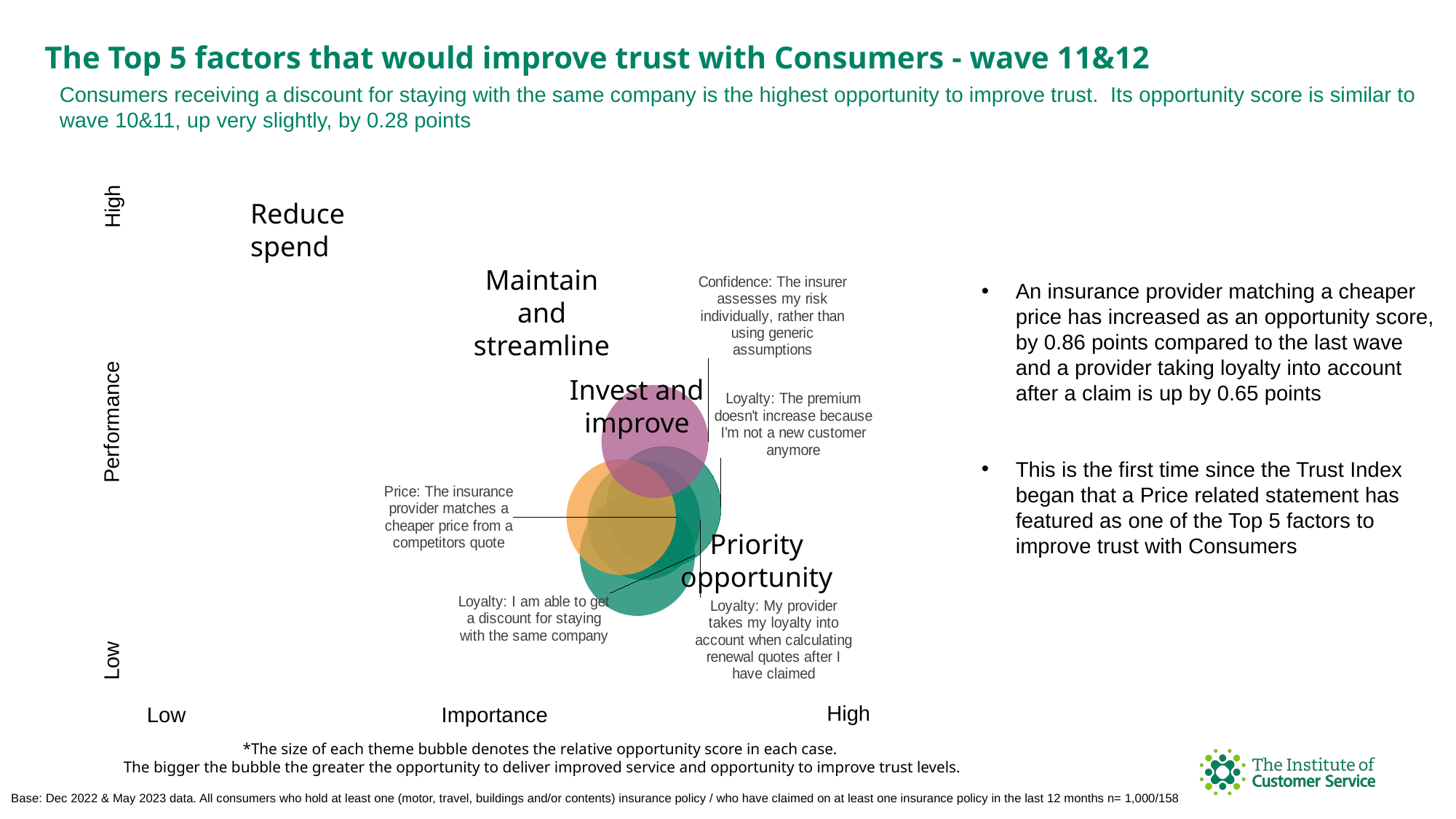
What is the name of the quadrant in the bottom-right of the chart? Priority opportunity How many factor bubbles are plotted on the chart? 5 Which factor has the largest bubble, indicating the highest opportunity score? Loyalty: I am able to get a discount for staying with the same company What is the label of the horizontal axis of the chart? Importance What kind of chart is shown on the slide? Bubble chart